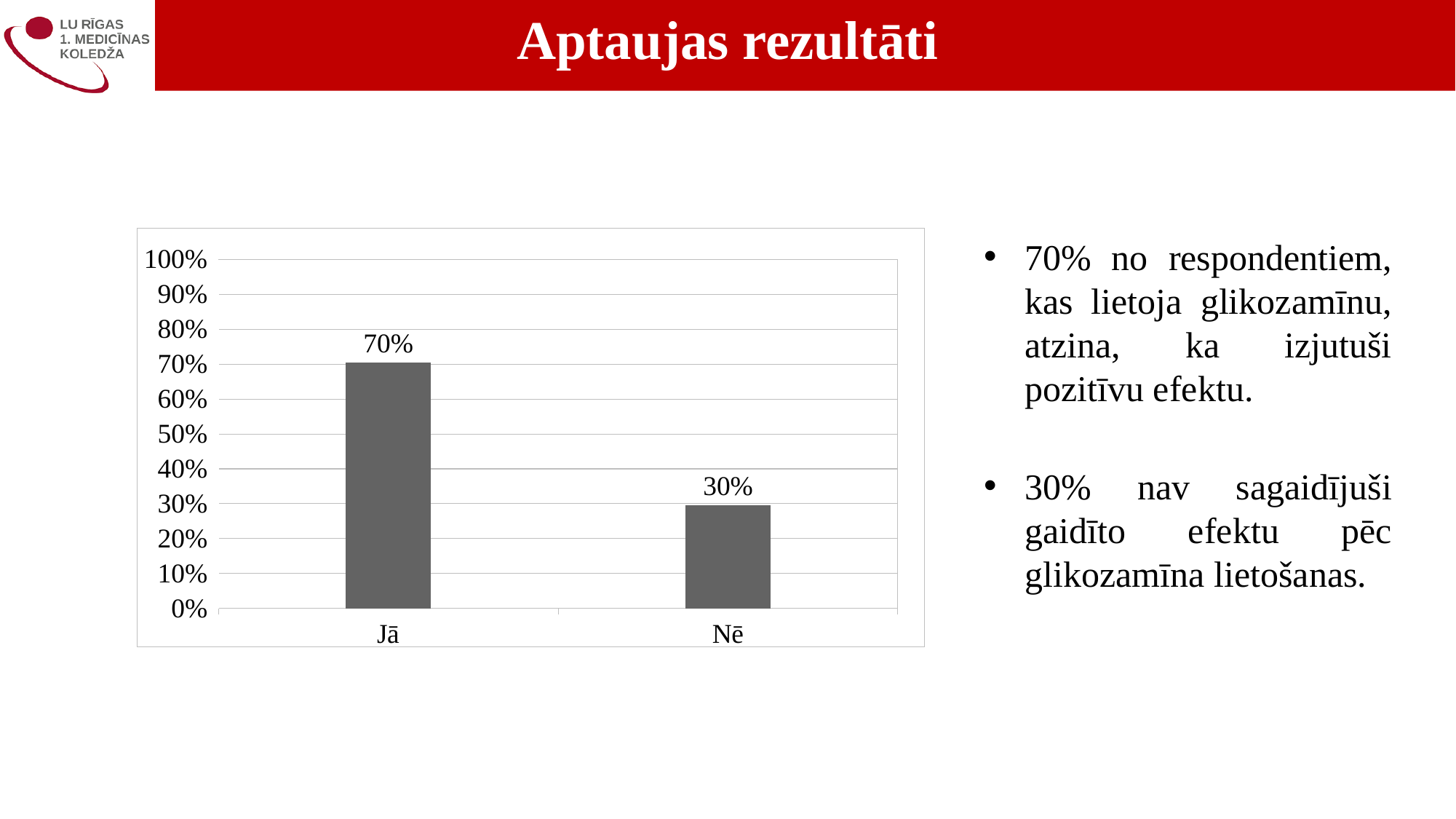
What is the value for Jā? 70% What is the maximum value shown on the y axis? 100% How many categories are shown on the x axis? 2 Is the value for Nē greater or less than 50%? less What is the value for Nē? 30% What kind of chart is shown on the slide? bar chart Which is larger, the value for Jā or the value for Nē? Jā Which category has the lowest value? Nē What colour are the bars in the chart? grey Is the value for Jā greater or less than 60%? greater Which category has the highest value? Jā What is the difference between the values for Jā and Nē? 40%